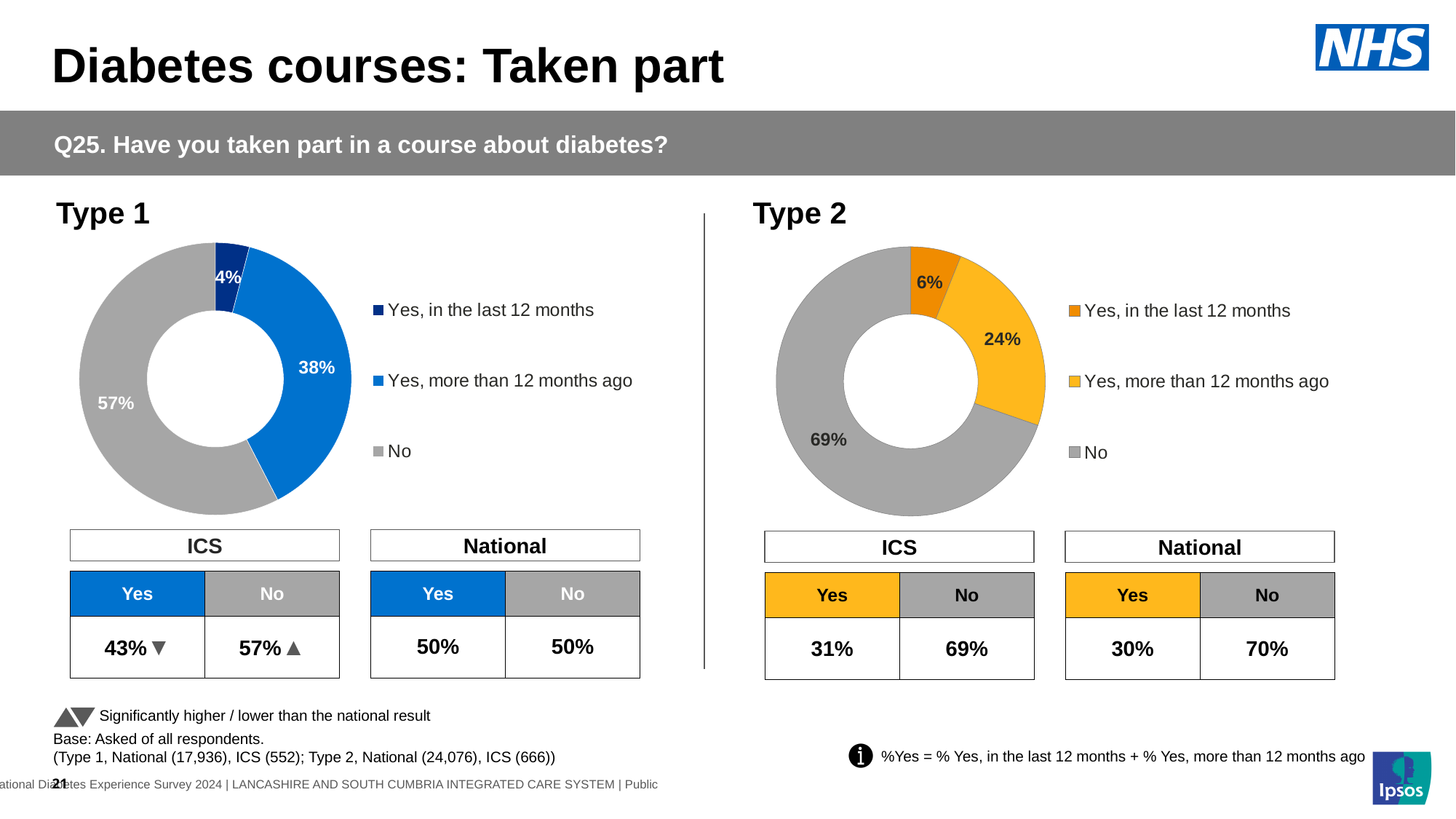
In the Type 2 chart, what is the difference between the 'No' share and the 'Yes, more than 12 months ago' share? 45% In the Type 1 chart, what percentage of respondents answered 'No'? 57% In the Type 1 chart, what is the combined share of the two 'Yes' categories? 42% What kind of chart is used for Type 1? Doughnut chart In the Type 2 chart, what percentage answered 'Yes, more than 12 months ago'? 24% In the Type 1 chart, what percentage answered 'Yes, in the last 12 months'? 4% In the Type 2 chart, which category has the largest share? No Which is larger: the 'Yes, in the last 12 months' share in the Type 1 chart or in the Type 2 chart? Type 2 In the Type 1 chart, which category has the smallest share? Yes, in the last 12 months In the Type 2 chart, what colour is the 'No' segment? Grey How many categories does the legend of the Type 2 chart list? 3 In the Type 1 chart, what colour is the 'Yes, more than 12 months ago' segment? Blue